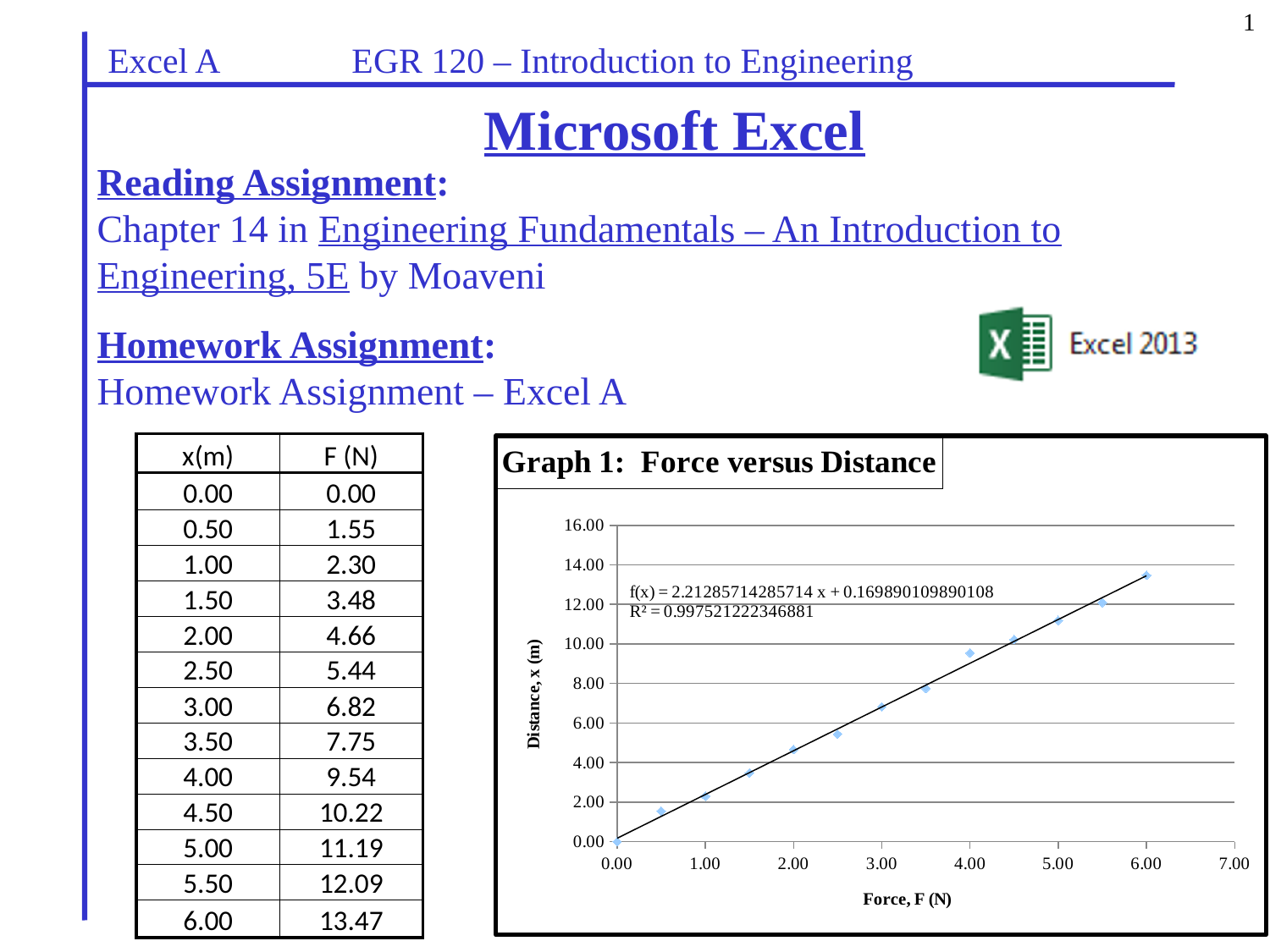
In Graph 1, is the value of the point at 4.00 on the x axis greater or less than 8.00? greater In Graph 1, is the value of the point at 2.50 on the x axis greater or less than 6.00? less In Graph 1, at which x-axis value is the highest plotted point? 6.00 In Graph 1, is the value of the point at 1.00 on the x axis greater or less than 4.00? less What kind of chart is Graph 1: Force versus Distance? Scatter chart How many data points are plotted in Graph 1: Force versus Distance? 13 In Graph 1, at which x-axis value is the lowest plotted point? 0.00 What is the R² value shown on Graph 1: Force versus Distance? 0.997521222346881 In Graph 1, do the plotted values rise or fall as you move along the x axis? Rise What is the label of the vertical axis in Graph 1: Force versus Distance? Distance, x (m)